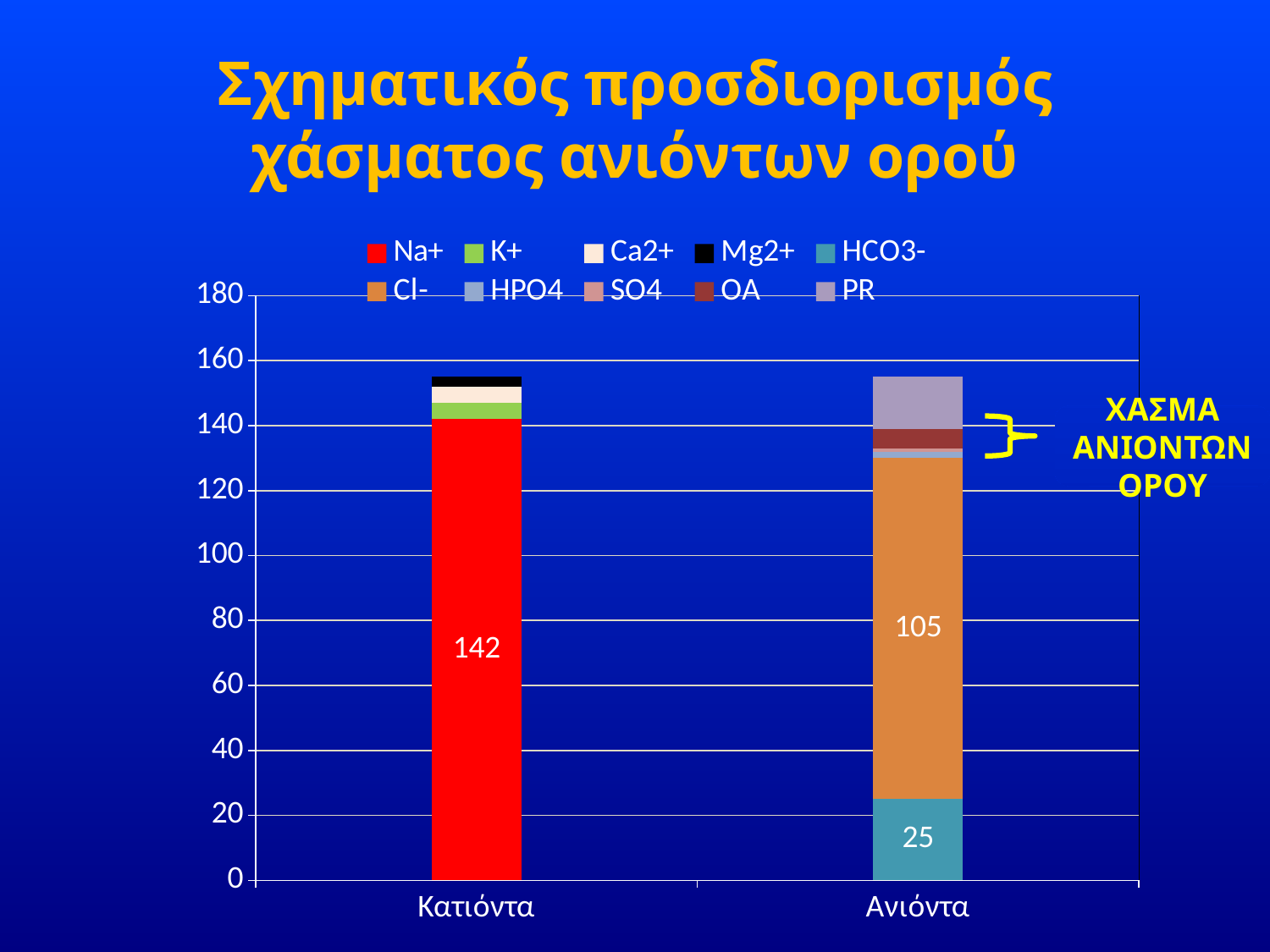
How many series does the legend list? 10 What is the difference between the Na+ value (142) and the Cl- value (105)? 37 What is the value of the Cl- segment in the Ανιόντα bar? 105 Which labelled segment has the smallest value on the chart? HCO3- What is the value of the Na+ segment in the Κατιόντα bar? 142 What kind of chart is shown on the slide? Stacked bar chart Which is larger, the Na+ segment or the Cl- segment? Na+ Which labelled segment has the largest value on the chart? Na+ What is the difference between the Cl- value and the HCO3- value in the Ανιόντα bar? 80 How many categories are shown on the x axis? 2 What is the value of the HCO3- segment in the Ανιόντα bar? 25 Is the total height of the Κατιόντα bar greater or less than 140? greater